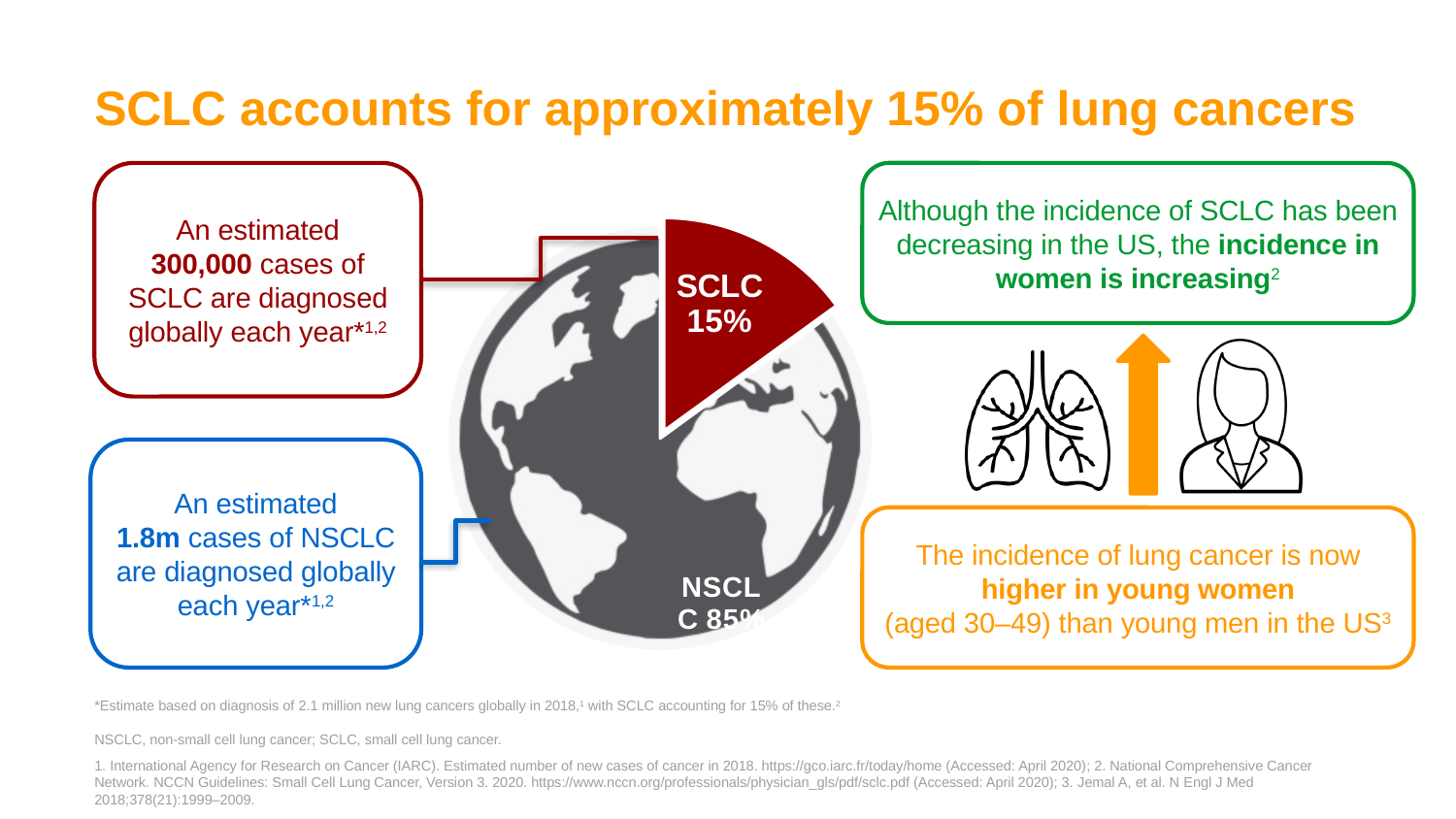
What is the title of the slide containing the pie chart? SCLC accounts for approximately 15% of lung cancers What share of lung cancers does the SCLC slice represent in the pie chart? 15% How many slices does the pie chart have? 2 What share of lung cancers does the NSCLC slice represent in the pie chart? 85% Which is larger in the pie chart, the SCLC slice or the NSCLC slice? NSCLC Which slice of the pie chart is the largest? NSCLC What is the combined share of the SCLC and NSCLC slices in the pie chart? 100% By how many percentage points does the NSCLC share exceed the SCLC share in the pie chart? 70 percentage points What kind of chart is shown on the slide? Pie chart What colour is the SCLC slice in the pie chart? Dark red Which slice of the pie chart is the smallest? SCLC